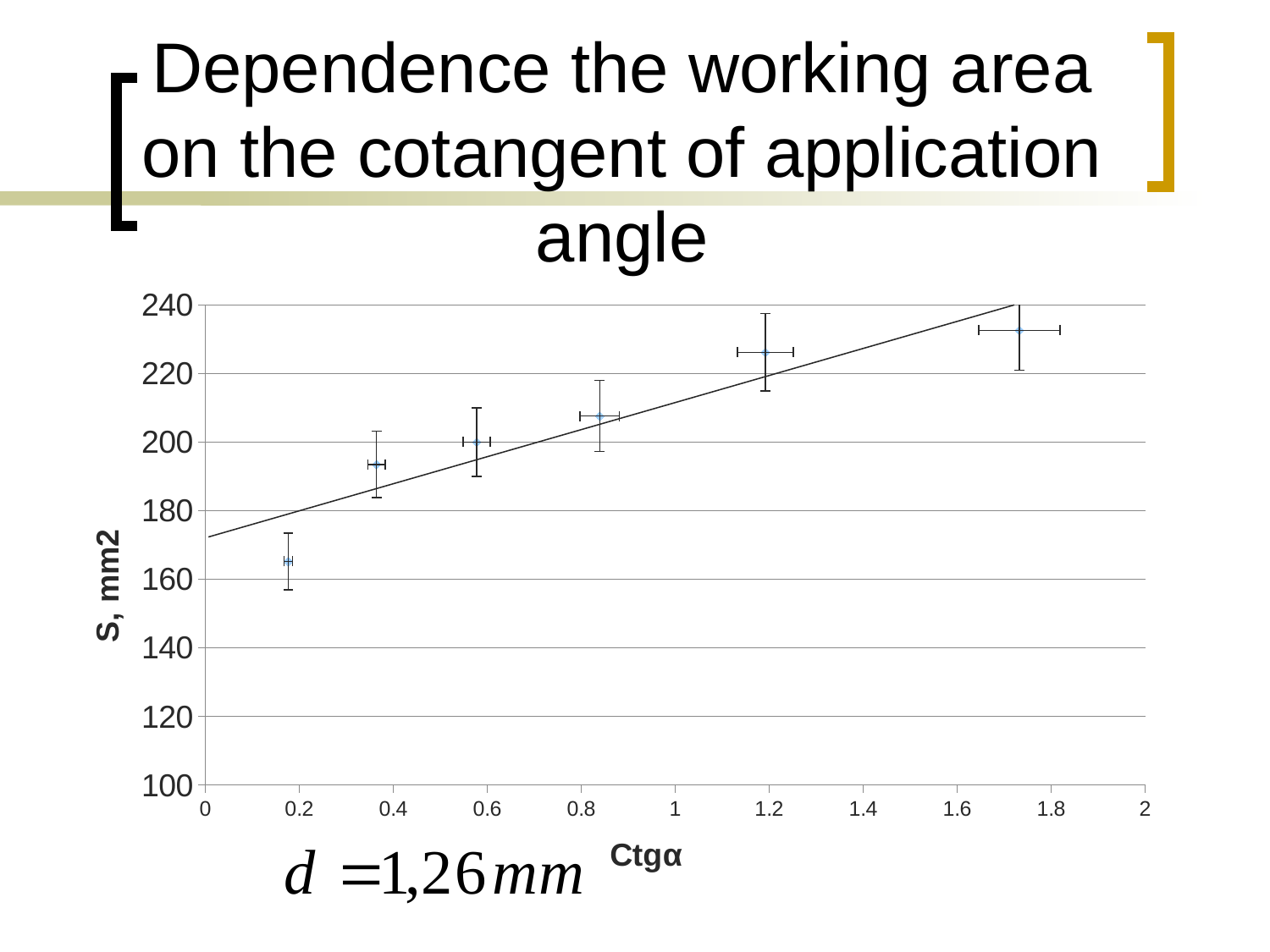
What is the highest tick value shown on the vertical axis? 240 What kind of chart is shown on the slide? scatter chart Is the value of S for the rightmost data point greater or less than 220? greater Is the value of S for the leftmost data point greater or less than 180? less How many data points are plotted on the chart? 6 What is the label of the horizontal axis? Ctgα Is the value of S for the second data point from the left greater or less than 200? less Which data point has the lowest value of S? the leftmost point What is the label of the vertical axis? S, mm2 Do the values of S rise or fall as Ctgα increases along the x axis? rise Which data point has the highest value of S, the leftmost or the rightmost? the rightmost